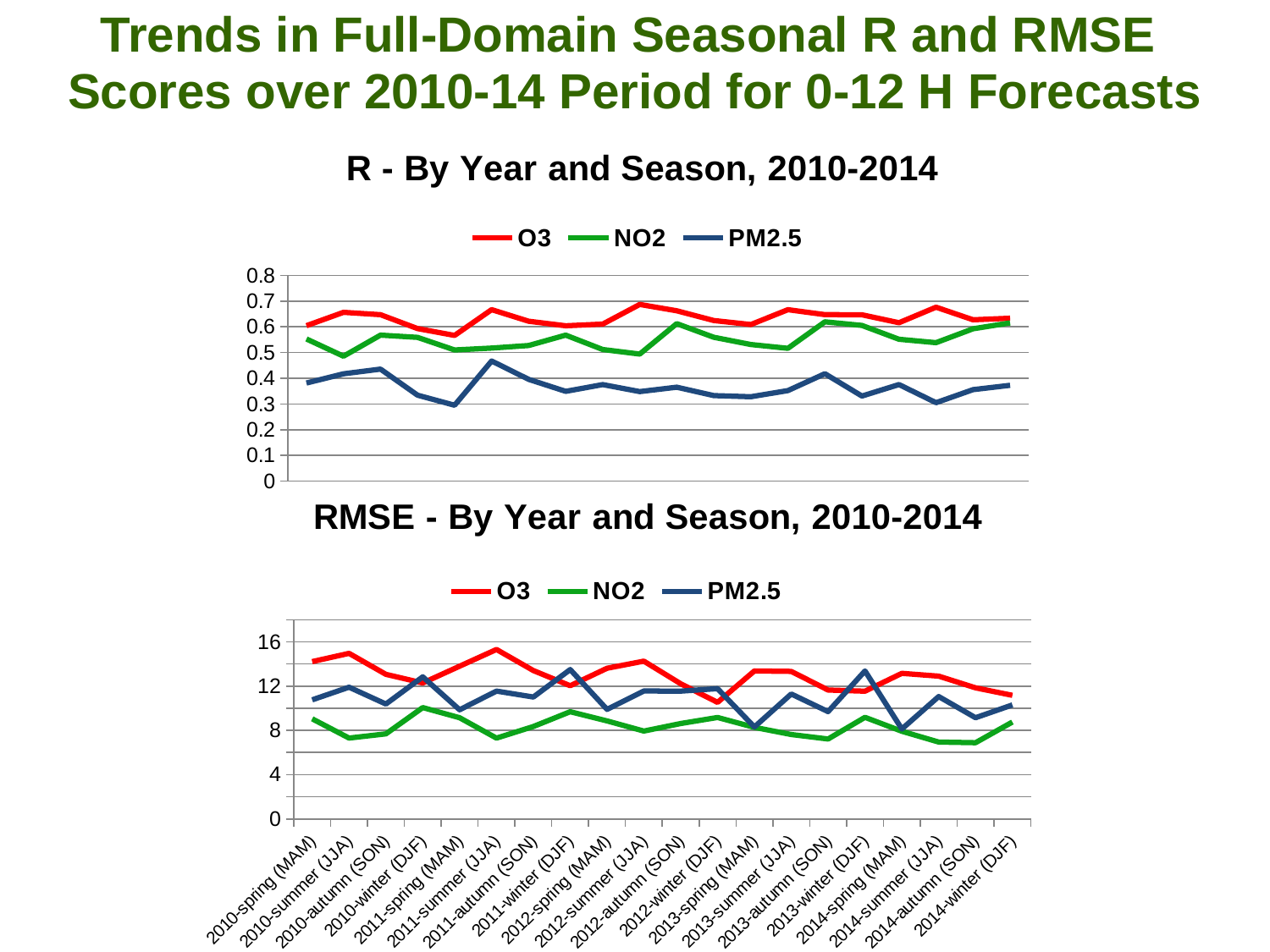
In the 'R - By Year and Season, 2010-2014' chart, which series is higher at 2013-spring (MAM), O3 or PM2.5? O3 How many series does the legend of the 'RMSE - By Year and Season, 2010-2014' chart list? 3 Which series is drawn in green in both charts on the slide? NO2 In the 'R - By Year and Season, 2010-2014' chart, is the PM2.5 value for 2011-summer (JJA) greater or less than 0.4? greater In the 'R - By Year and Season, 2010-2014' chart, is the O3 value for 2012-summer (JJA) greater or less than 0.6? greater How many season categories are plotted along the x axis of the 'RMSE - By Year and Season, 2010-2014' chart? 20 In the 'RMSE - By Year and Season, 2010-2014' chart, is the PM2.5 value for 2013-winter (DJF) greater or less than 12? greater What kind of chart is the 'R - By Year and Season, 2010-2014' chart? line chart In the 'RMSE - By Year and Season, 2010-2014' chart, which series is higher at 2010-spring (MAM), O3 or NO2? O3